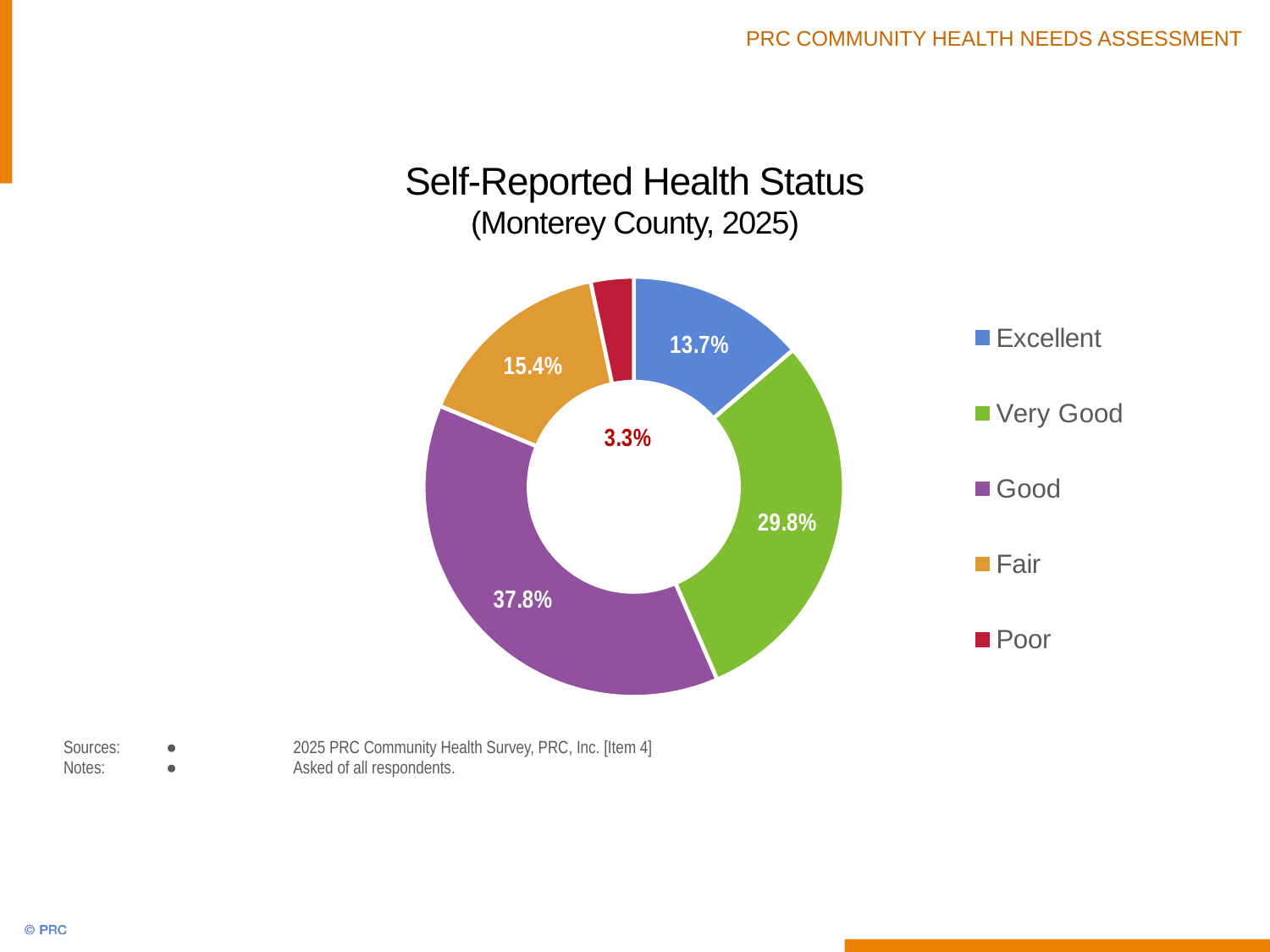
What type of chart is used to show self-reported health status? Pie chart (donut) What percentage of respondents reported their health status as Excellent? 13.7% What is the title of the chart? Self-Reported Health Status (Monterey County, 2025) How many health status categories are shown in the chart? 5 Which health status category has the largest share? Good What is the difference in percentage points between Good and Very Good? 8.0 percentage points What colour represents the Very Good category in the chart? Green What percentage of respondents reported their health status as Good? 37.8% What percentage of respondents reported their health status as Poor? 3.3% What percentage of respondents reported their health status as Fair? 15.4% Which is larger, the share for Fair or the share for Excellent? Fair Which health status category has the smallest share? Poor